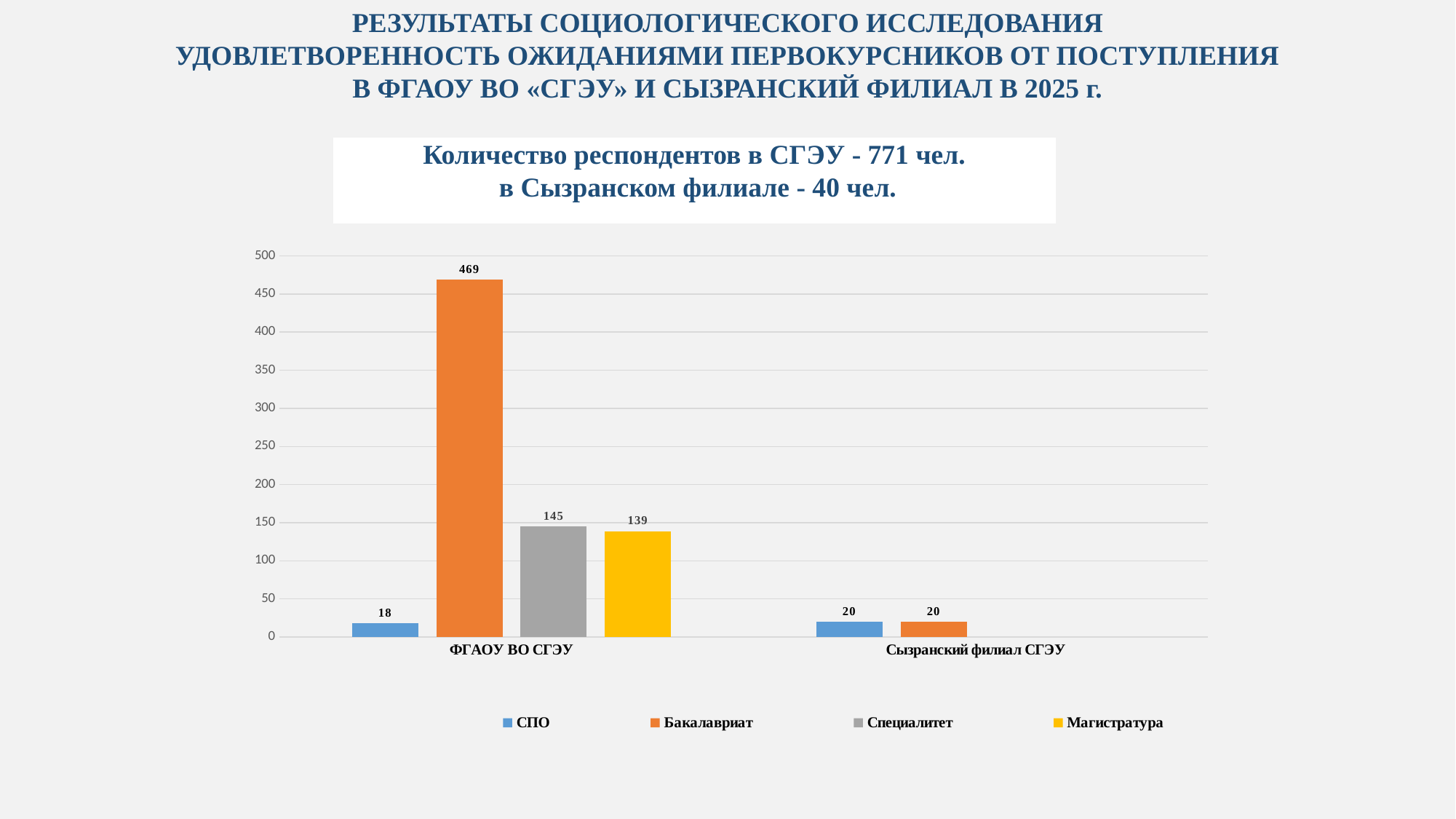
Which is larger in the ФГАОУ ВО СГЭУ category: Специалитет or Магистратура? Специалитет What is the difference between the Бакалавриат and Специалитет values in the ФГАОУ ВО СГЭУ category? 324 What is the value for Магистратура in the ФГАОУ ВО СГЭУ category? 139 Which series has the lowest value in the ФГАОУ ВО СГЭУ category? СПО How many series does the legend list? 4 What is the value for СПО in the ФГАОУ ВО СГЭУ category? 18 What colour represents Магистратура in the chart? Yellow What kind of chart is shown on the slide? Bar chart What is the value for Бакалавриат in the Сызранский филиал СГЭУ category? 20 What is the value for Бакалавриат in the ФГАОУ ВО СГЭУ category? 469 What is the value for Специалитет in the ФГАОУ ВО СГЭУ category? 145 Which series has the highest value in the ФГАОУ ВО СГЭУ category? Бакалавриат